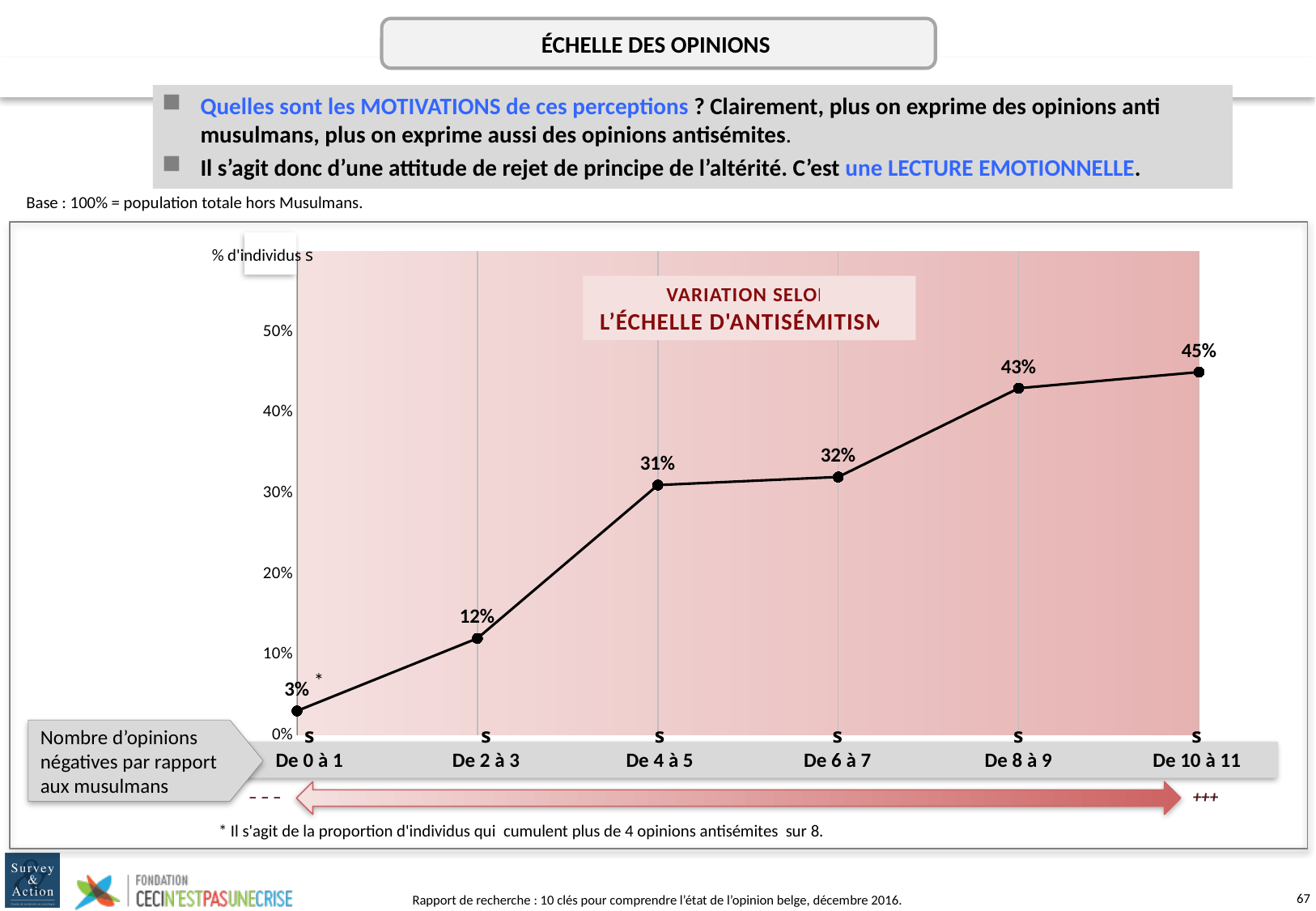
What does the label to the left of the x axis say the categories represent? Nombre d'opinions négatives par rapport aux musulmans What is the difference between the values for 'De 4 à 5' and 'De 2 à 3'? 19% Which category has the highest value? De 10 à 11 Which is larger, the value for 'De 6 à 7' or the value for 'De 2 à 3'? De 6 à 7 Do the values rise or fall along the x axis from 'De 0 à 1' to 'De 10 à 11'? Rise What is the value for the category 'De 8 à 9'? 43% What is the value for the category 'De 4 à 5'? 31% What is the difference between the values for 'De 10 à 11' and 'De 0 à 1'? 42% Which category has the lowest value? De 0 à 1 What is the value for the category 'De 0 à 1'? 3% What kind of chart is shown on the slide? Line chart How many categories are plotted on the x axis? 6